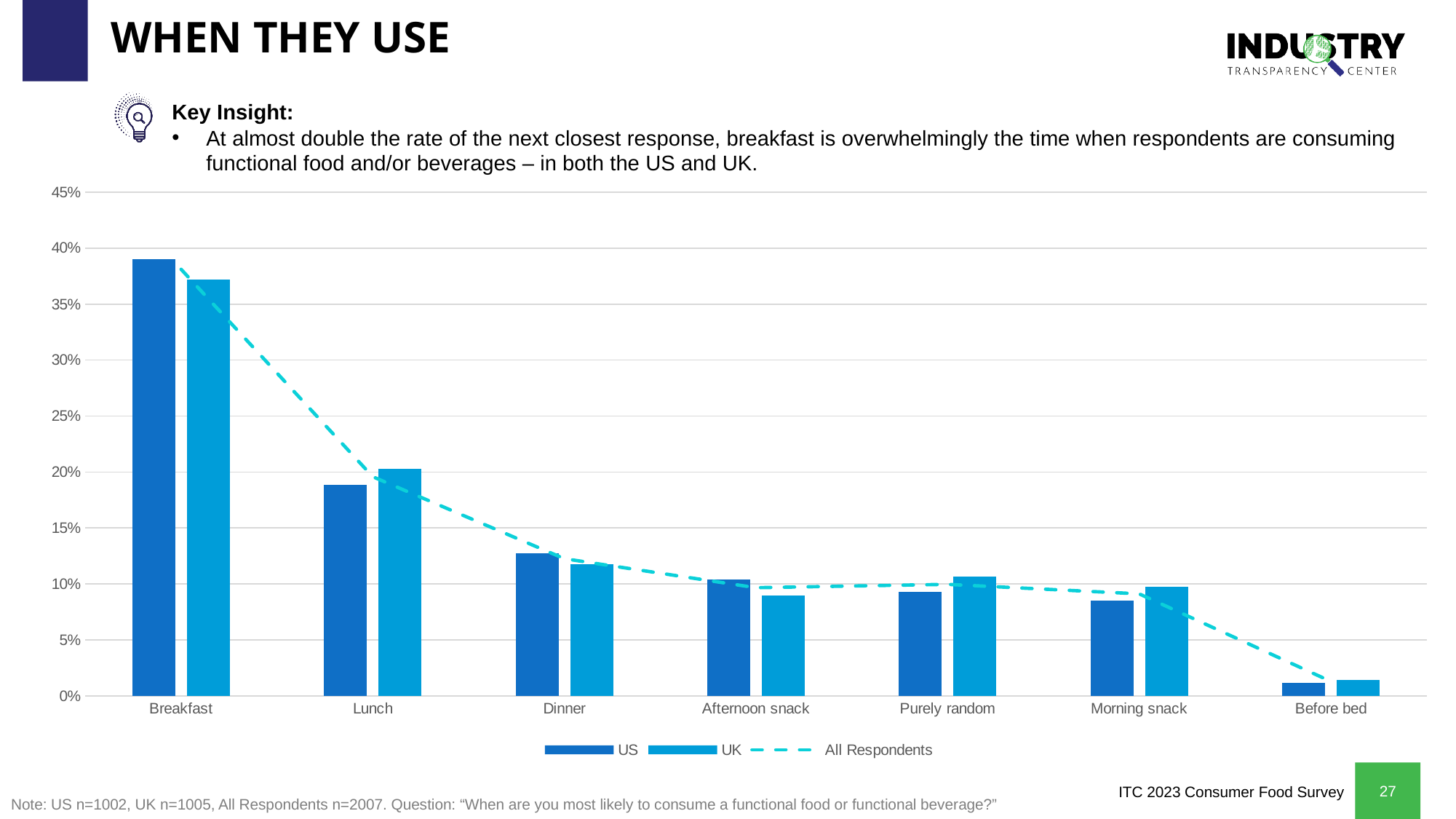
For Lunch, which is larger, the US value or the UK value? UK What kind of chart is shown on the slide? bar chart with a dashed line Which category has the lowest UK value? Before bed For Afternoon snack, which is larger, the US value or the UK value? US Is the US value for Dinner greater or less than 10%? greater Is the UK value for Lunch greater or less than 25%? less What are the three entries listed in the chart's legend? US, UK, All Respondents Does the All Respondents dashed line rise or fall from Breakfast to Before bed? fall Which category has the highest US value? Breakfast Is the US value for Breakfast greater or less than 35%? greater How many categories are shown on the x axis of the chart? 7 How many series does the chart's legend list? 3